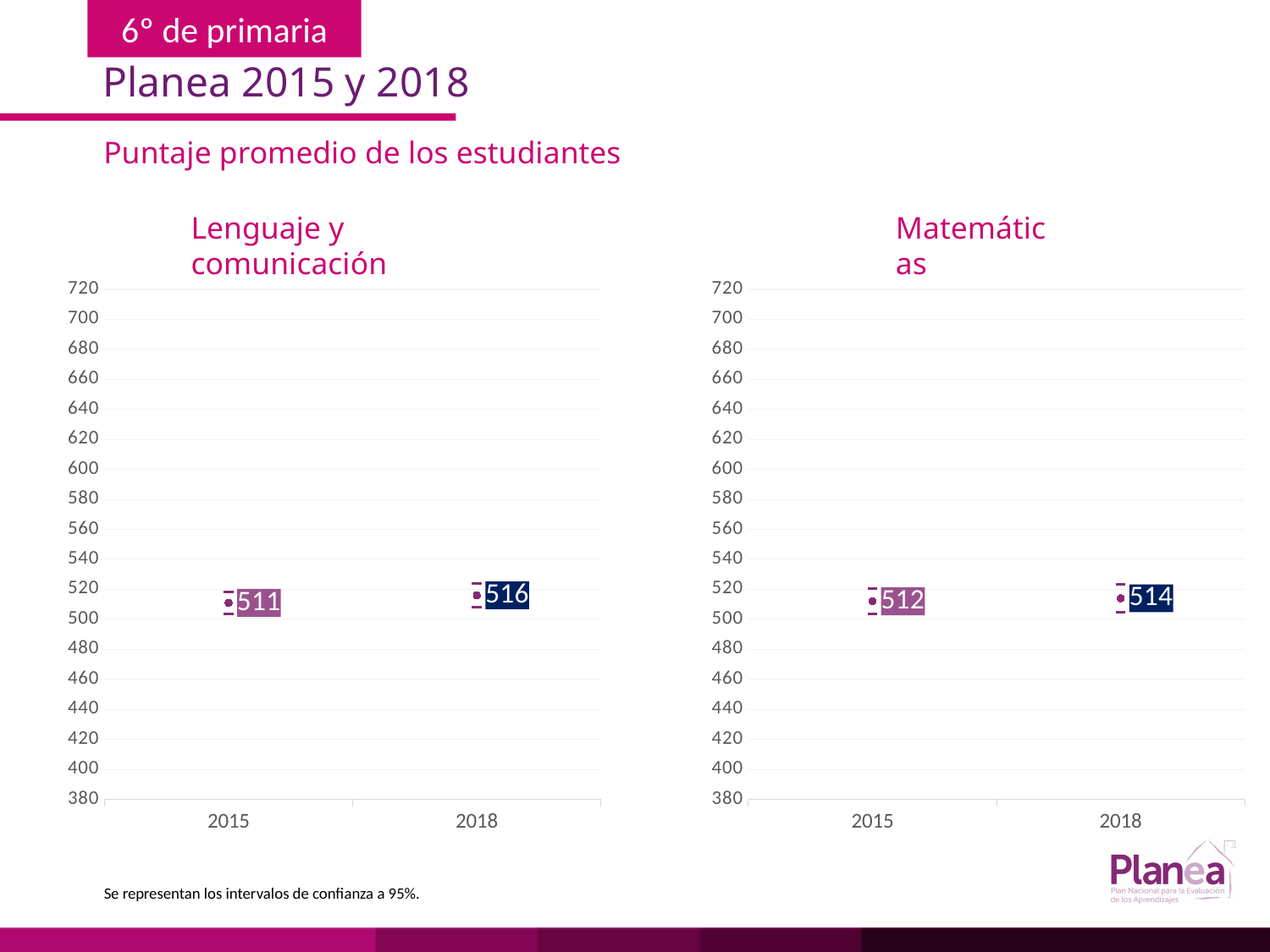
In the Lenguaje y comunicación chart, which year has the higher average score? 2018 In the Matemáticas chart, what is the difference between the 2018 and 2015 average scores? 2 In the Matemáticas chart, what is the average score for 2015? 512 In the Lenguaje y comunicación chart, by how many points did the average score change from 2015 to 2018? 5 In the Lenguaje y comunicación chart, is the 2015 value greater or less than 520? less In the Matemáticas chart, what is the average score for 2018? 514 Is the 2018 value in the Matemáticas chart larger or smaller than the 2018 value in the Lenguaje y comunicación chart? smaller In the Matemáticas chart, which year has the lower average score? 2015 How many years are plotted in the Matemáticas chart? 2 In the Lenguaje y comunicación chart, what is the average score for 2015? 511 In the Lenguaje y comunicación chart, what is the average score for 2018? 516 In the Matemáticas chart, do the average scores rise or fall from 2015 to 2018? rise